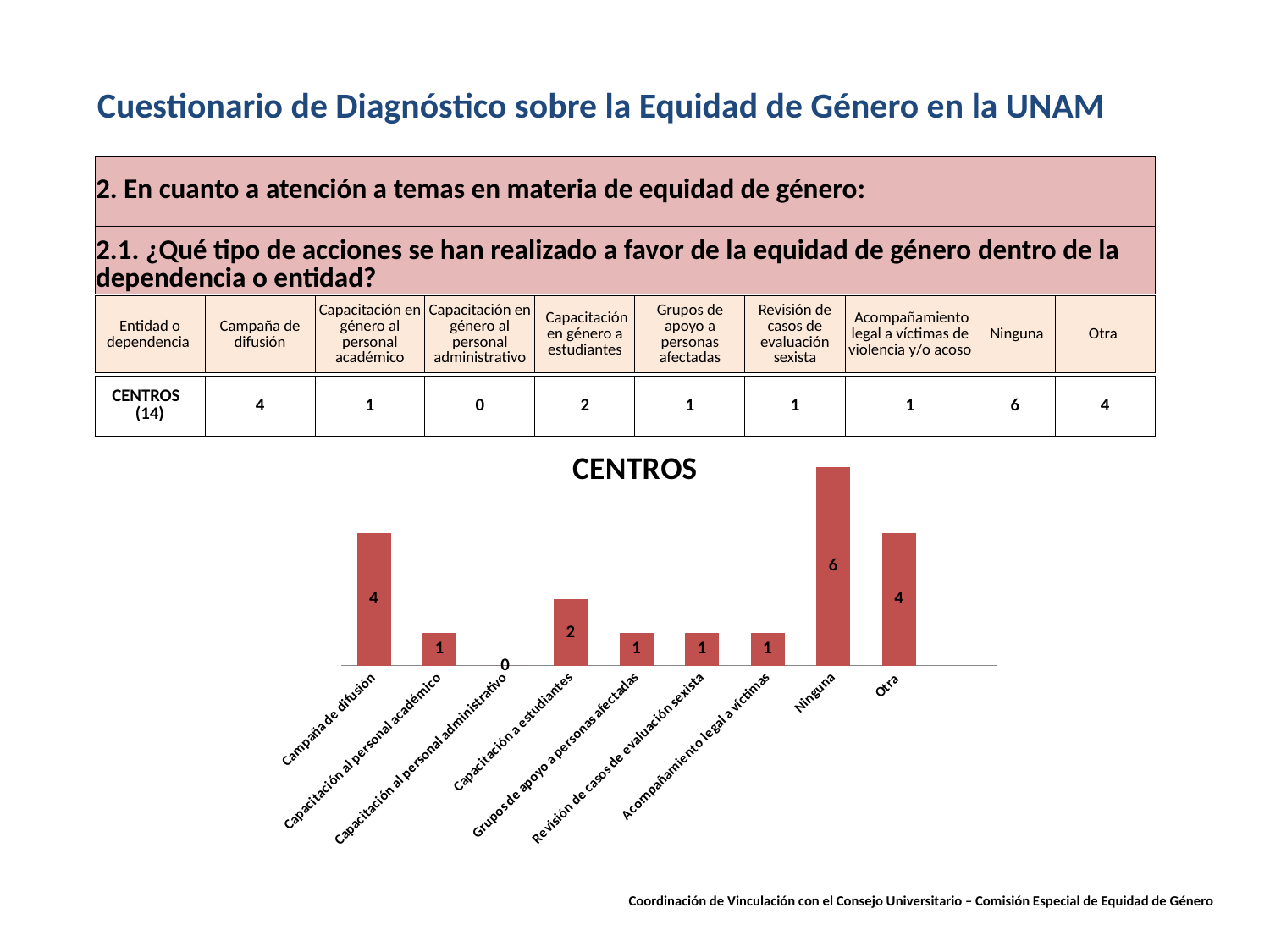
What is the difference between the values for Otra and Acompañamiento legal a víctimas in the CENTROS chart? 3 What is the value for Campaña de difusión in the CENTROS chart? 4 What is the title of the chart on the slide? CENTROS What is the value for Ninguna in the CENTROS chart? 6 What is the difference between the values for Ninguna and Otra in the CENTROS chart? 2 How many categories are shown in the CENTROS chart? 9 Which category has the highest value in the CENTROS chart? Ninguna Which category has the lowest value in the CENTROS chart? Capacitación al personal administrativo What is the value for Capacitación al personal administrativo in the CENTROS chart? 0 What type of chart is the CENTROS chart? Bar chart What is the value for Capacitación a estudiantes in the CENTROS chart? 2 Which is larger in the CENTROS chart: Campaña de difusión or Capacitación a estudiantes? Campaña de difusión